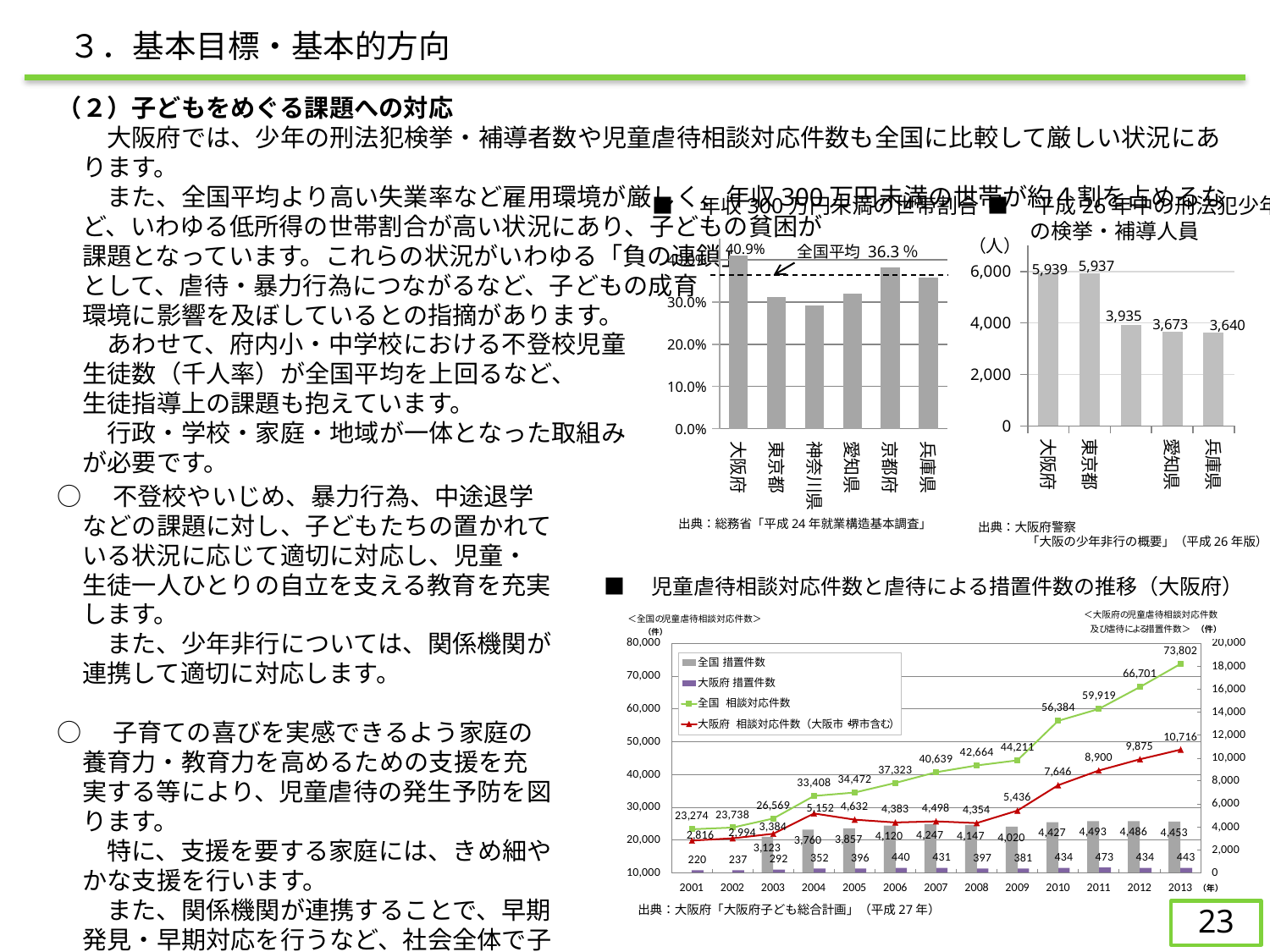
In the chart titled 児童虐待相談対応件数と虐待による措置件数の推移（大阪府）, how many series does the legend list? 4 In the chart titled 年収300万円未満の世帯割合, what is the value shown for 大阪府? 40.9% In the chart titled 児童虐待相談対応件数と虐待による措置件数の推移（大阪府）, what is the 大阪府 措置件数 value for 2011? 473 In the chart titled 児童虐待相談対応件数と虐待による措置件数の推移（大阪府）, does the 全国 相談対応件数 series rise or fall from 2001 to 2013? Rise In the chart titled 年収300万円未満の世帯割合, what is the 全国平均 value shown? 36.3% In the chart titled 児童虐待相談対応件数と虐待による措置件数の推移（大阪府）, what is the 全国 相談対応件数 value for 2013? 73,802 In the chart titled 平成26年中の刑法犯少年の検挙・補導人員, what kind of chart is used? Bar chart In the chart titled 平成26年中の刑法犯少年の検挙・補導人員, what is the value for 大阪府? 5,939 In the chart titled 年収300万円未満の世帯割合, how many prefectures are plotted on the x axis? 6 In the chart titled 平成26年中の刑法犯少年の検挙・補導人員, what is the value for 兵庫県? 3,640 In the chart titled 年収300万円未満の世帯割合, is the value for 神奈川県 greater or less than 30.0%? less In the chart titled 平成26年中の刑法犯少年の検挙・補導人員, what is the difference between the values for 東京都 and 愛知県? 2,264